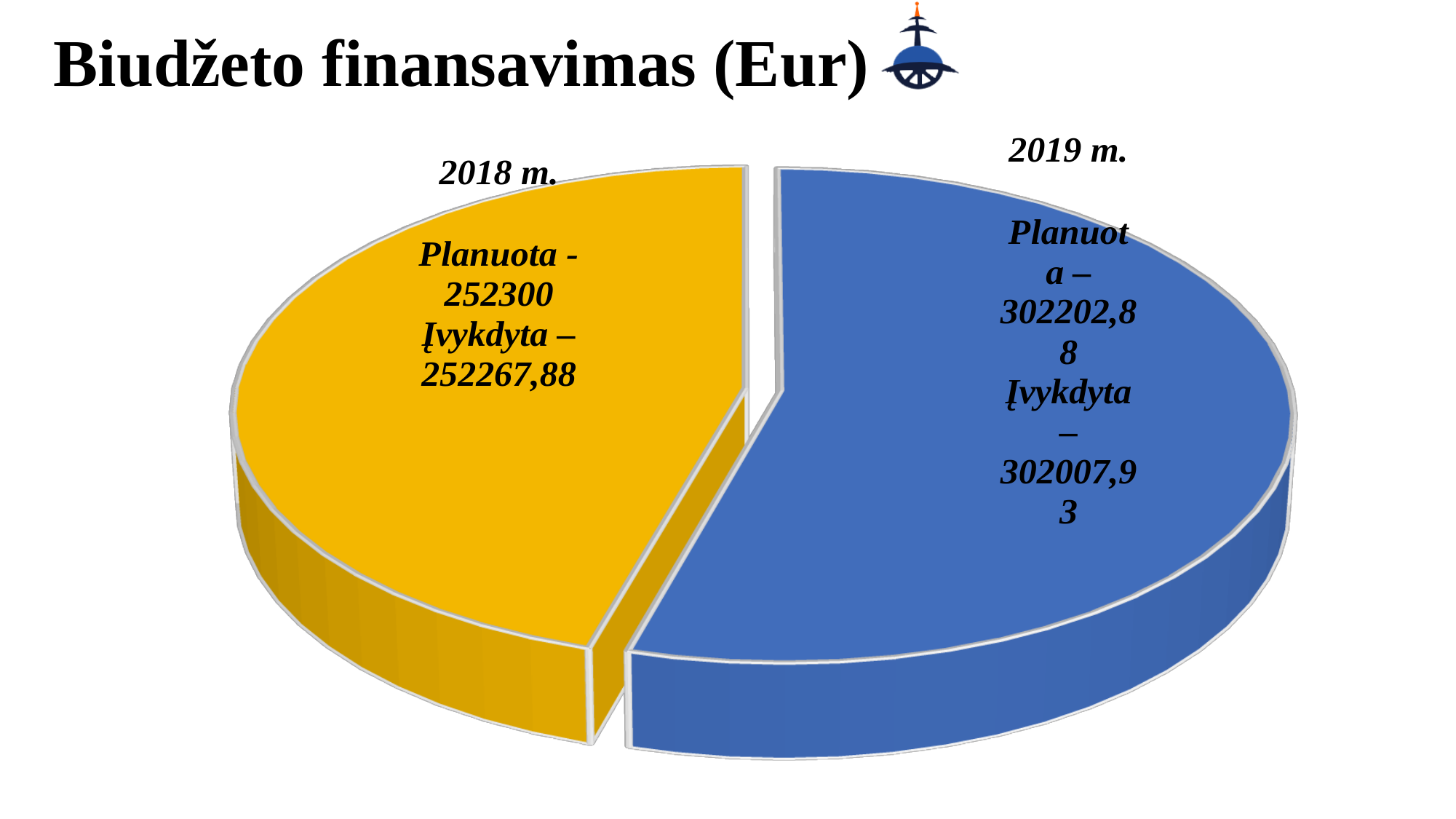
What is the difference between the planned and executed amounts for 2018 m.? 32,12 What is the planned (Planuota) amount for 2019 m.? 302202,88 What colour is the slice for 2019 m.? blue What kind of chart is shown on the slide? pie chart What is the difference between the planned amounts for 2019 m. and 2018 m.? 49902,88 How many slices does the pie chart have? 2 What is the executed (Įvykdyta) amount for 2018 m.? 252267,88 What is the planned (Planuota) amount for 2018 m.? 252300 Which year has the smaller slice of the pie? 2018 m. Is the executed amount for 2019 m. larger or smaller than the executed amount for 2018 m.? larger What is the executed (Įvykdyta) amount for 2019 m.? 302007,93 Which year has the larger slice of the pie? 2019 m.